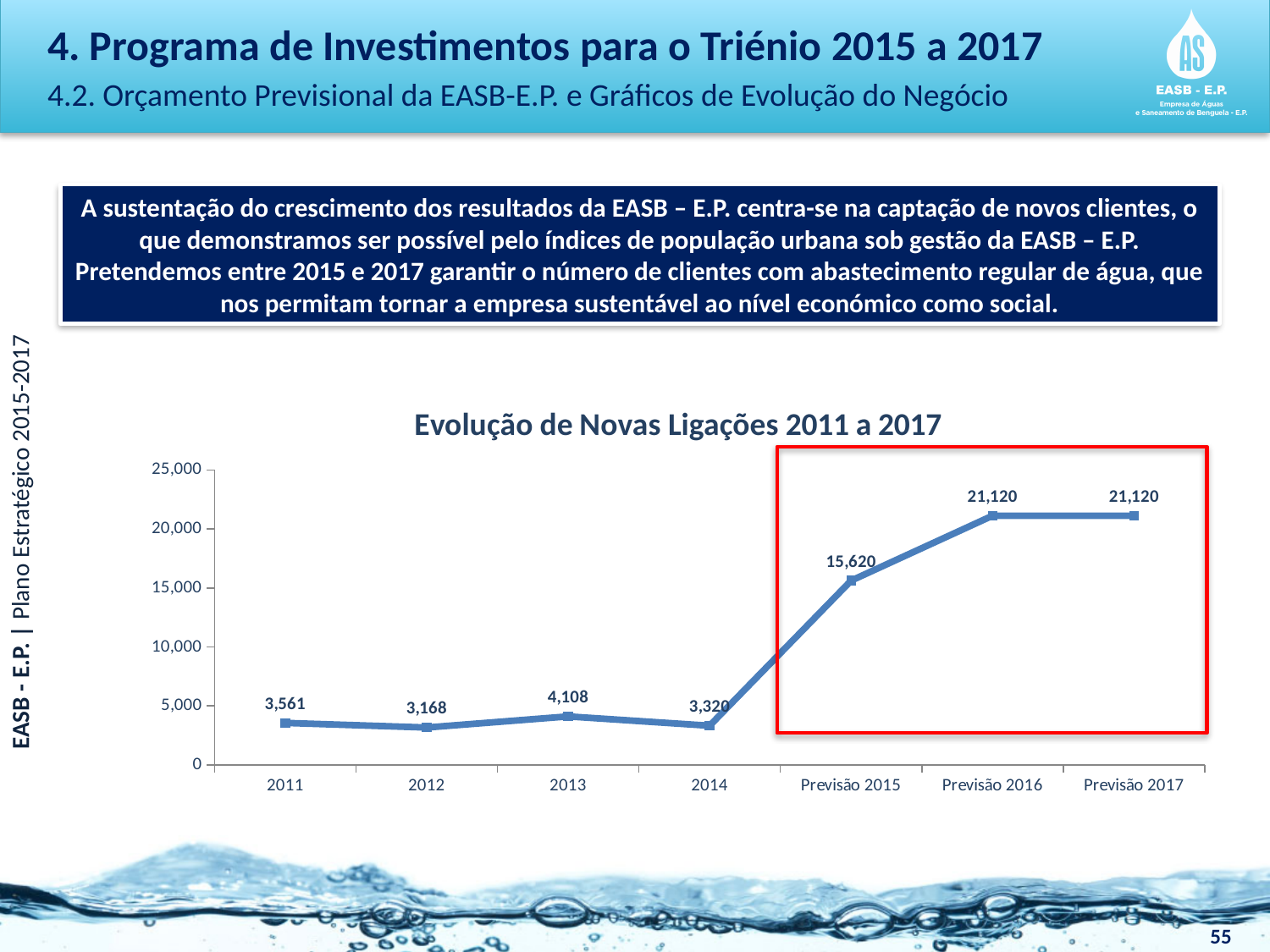
What is the difference between the values for Previsão 2016 and Previsão 2015? 5,500 What is the value for 2013? 4,108 What is the title of the chart? Evolução de Novas Ligações 2011 a 2017 Do the values rise or fall from 2014 to Previsão 2016? rise How many data points are plotted in the chart? 7 Which year has the lowest value in the chart? 2012 What is the value for 2011 in the chart? 3,561 What is the difference between the values for 2013 and 2014? 788 Which is larger, the value for 2011 or the value for 2012? 2011 What is the value for Previsão 2015? 15,620 What kind of chart is shown on the slide? line chart Is the value for Previsão 2017 greater or less than 20,000? greater